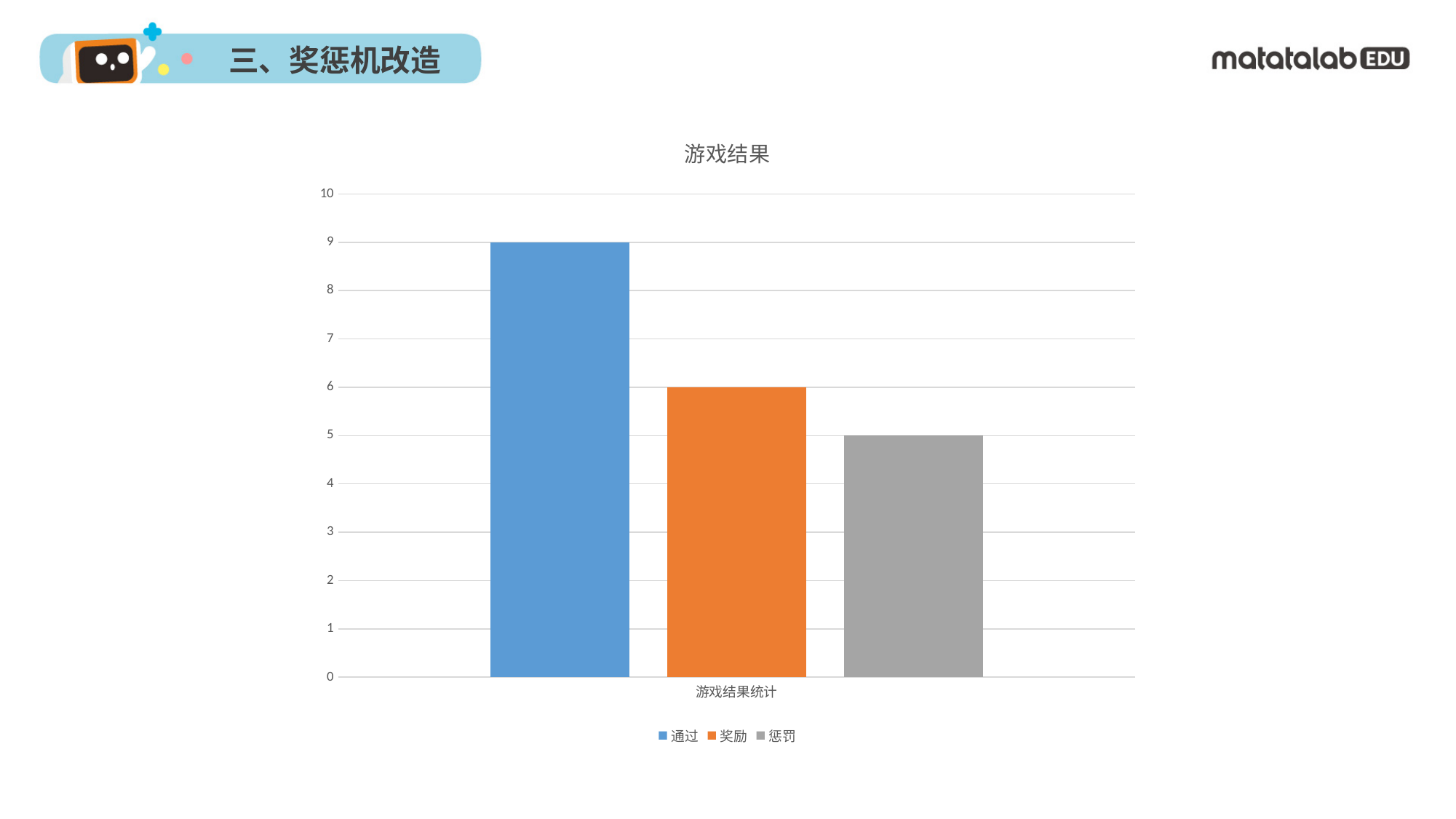
What is the value for 奖励 in the 游戏结果 chart? 6 What is the difference between the values for 通过 and 奖励? 3 How many series does the legend list? 3 Which series has the highest value in the 游戏结果 chart? 通过 What is the value for 通过 in the 游戏结果 chart? 9 Which is larger, the value for 通过 or the value for 惩罚? 通过 What is the difference between the values for 奖励 and 惩罚? 1 Which series has the lowest value in the 游戏结果 chart? 惩罚 What kind of chart is shown on the slide? bar chart Is the value for 奖励 greater or less than 5? greater What is the title of the chart? 游戏结果 What is the value for 惩罚 in the 游戏结果 chart? 5